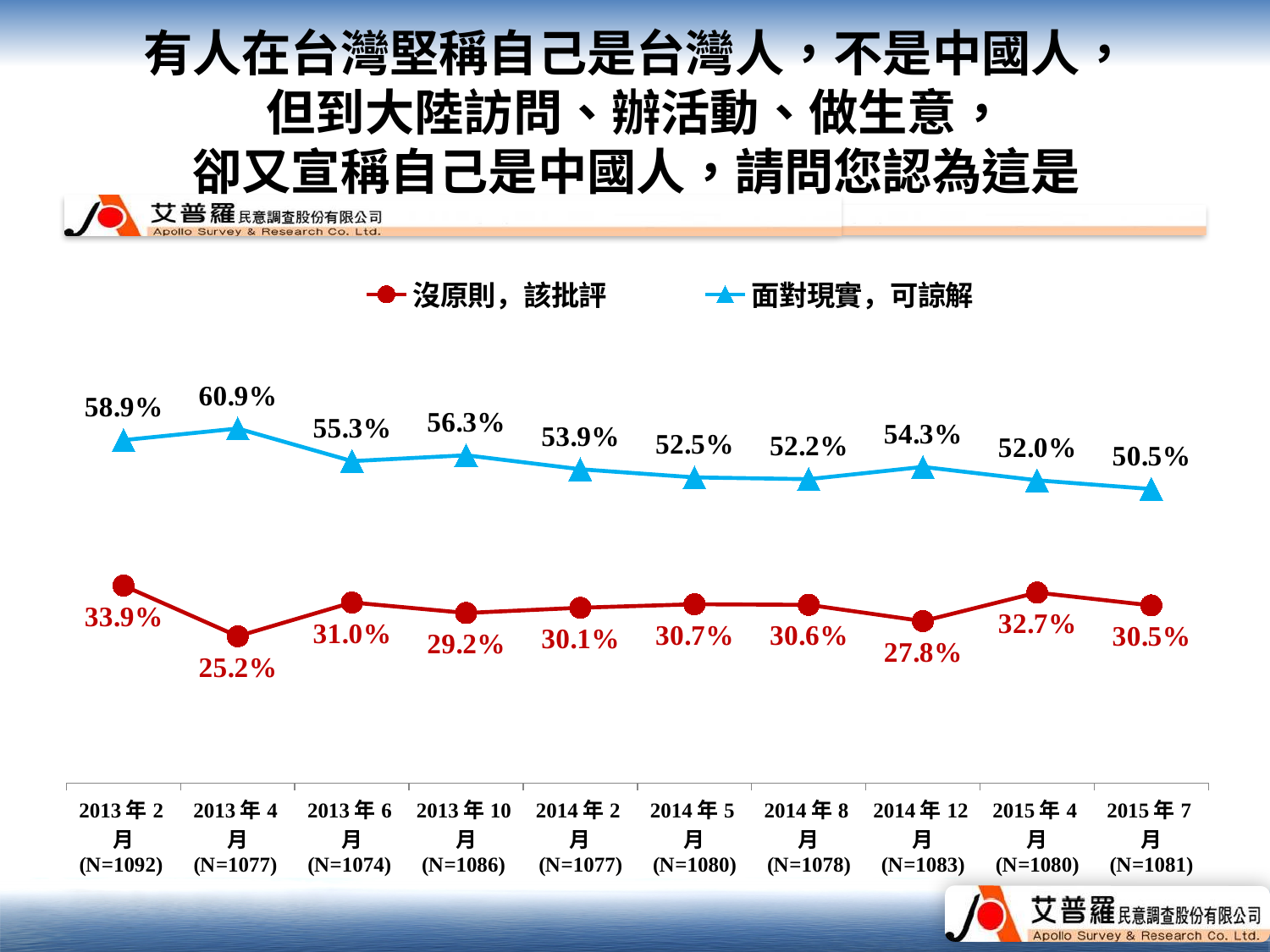
Does the value for 面對現實，可諒解 generally rise or fall from 2013年2月 to 2015年7月? fall What is the value for 面對現實，可諒解 in 2013年4月? 60.9% What is the difference between the 面對現實，可諒解 and 沒原則，該批評 values in 2013年2月? 25.0% What type of chart is shown on the slide? line chart What is the sample size (N) shown for 2013年10月? N=1086 Which marker shape is used for the 面對現實，可諒解 series? triangle How many series does the legend list? 2 Which is larger in 2014年12月: the value for 面對現實，可諒解 or for 沒原則，該批評? 面對現實，可諒解 In which time point is the value for 面對現實，可諒解 the highest? 2013年4月 What is the value for 沒原則，該批評 in 2015年7月? 30.5% In which time point is the value for 沒原則，該批評 the lowest? 2013年4月 How many time points are plotted along the x axis? 10